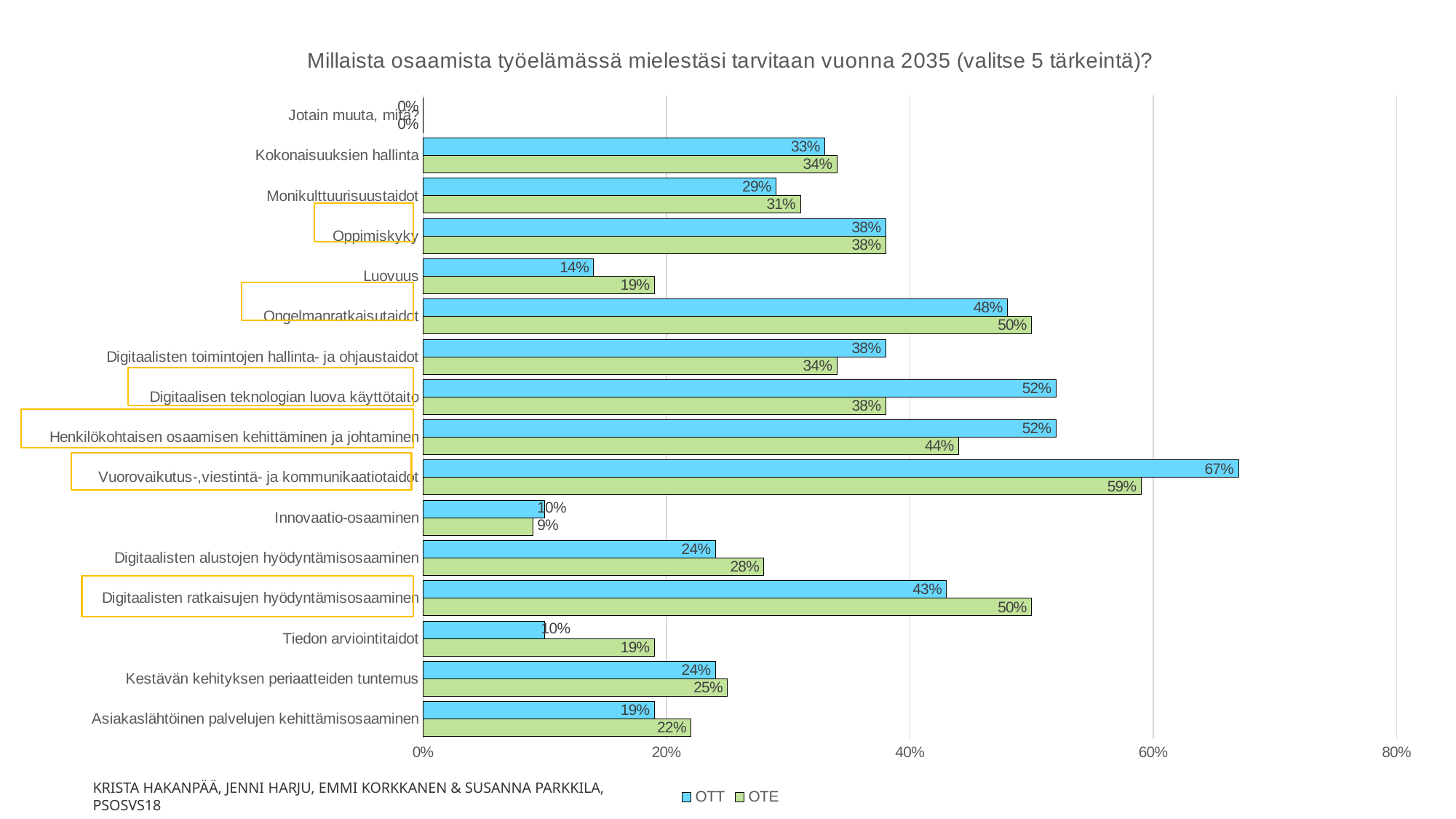
How many series does the legend list? 2 What is the OTT value for Vuorovaikutus-, viestintä- ja kommunikaatiotaidot? 67% What is the OTT value for Luovuus? 14% How many categories are shown on the chart? 16 Which is larger for Digitaalisten ratkaisujen hyödyntämisosaaminen, the OTT value or the OTE value? OTE What is the difference between the OTT and OTE values for Digitaalisen teknologian luova käyttötaito? 14% Which category has the highest OTE value? Vuorovaikutus-, viestintä- ja kommunikaatiotaidot What is the OTE value for Digitaalisten ratkaisujen hyödyntämisosaaminen? 50% What type of chart is shown on the slide? Bar chart Is the OTT value for Ongelmanratkaisutaidot greater or less than 40%? greater What is the difference between the OTE and OTT values for Tiedon arviointitaidot? 9% Which category has the lowest OTE value, excluding Jotain muuta, mitä? Innovaatio-osaaminen